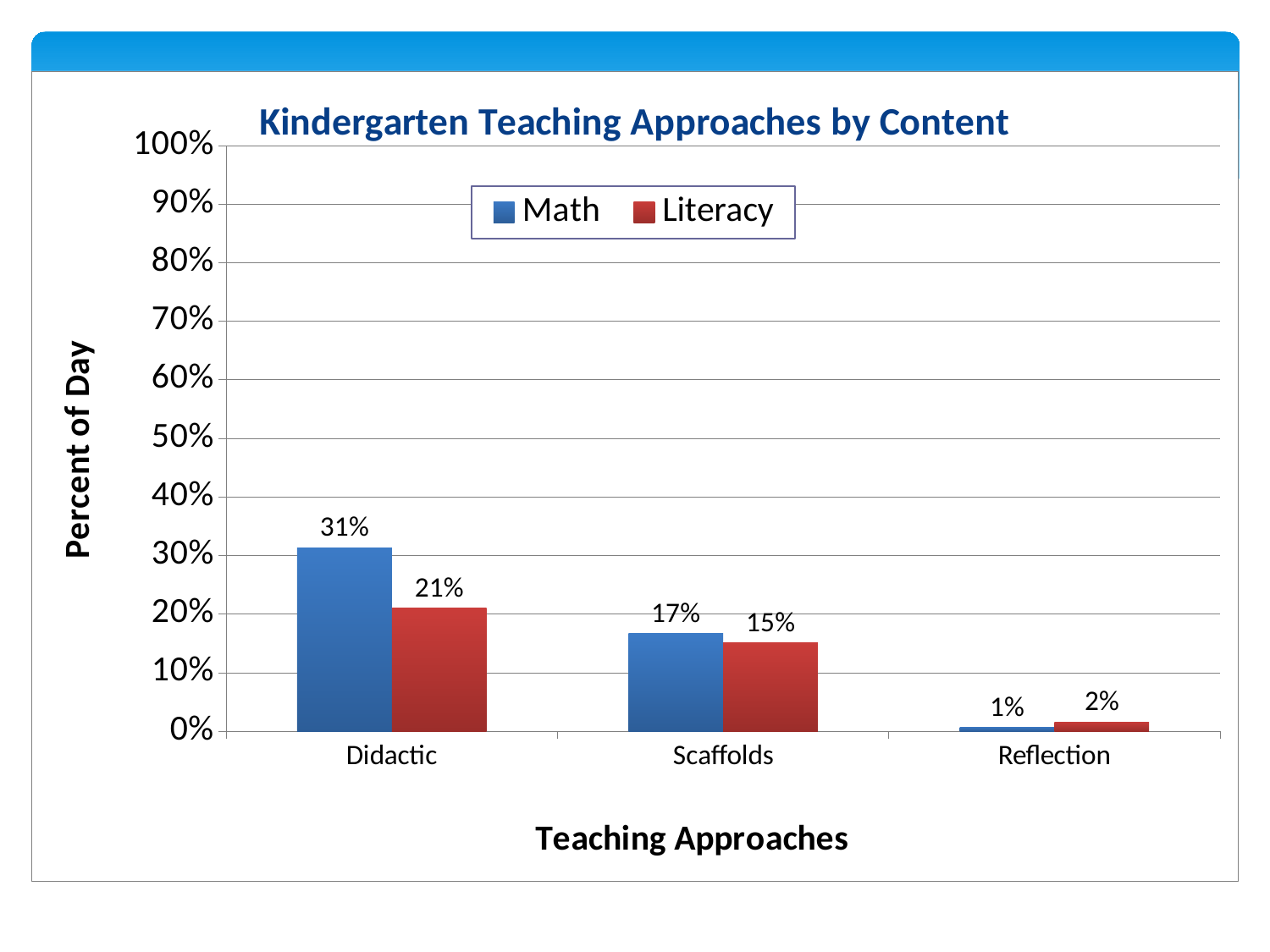
What is the title of the chart? Kindergarten Teaching Approaches by Content What is the difference between the Math and Literacy values for Didactic? 10% Which is larger for Scaffolds, the Math value or the Literacy value? Math What is the Literacy value for Scaffolds? 15% Is the Math value for Didactic greater or less than 40%? less What is the Literacy value for Reflection? 2% Which teaching approach has the lowest Literacy value? Reflection How many series does the legend list? 2 What kind of chart is shown? bar chart What is the Math value for Didactic? 31% Which teaching approach has the highest Math value? Didactic How many teaching approaches are shown on the x axis? 3